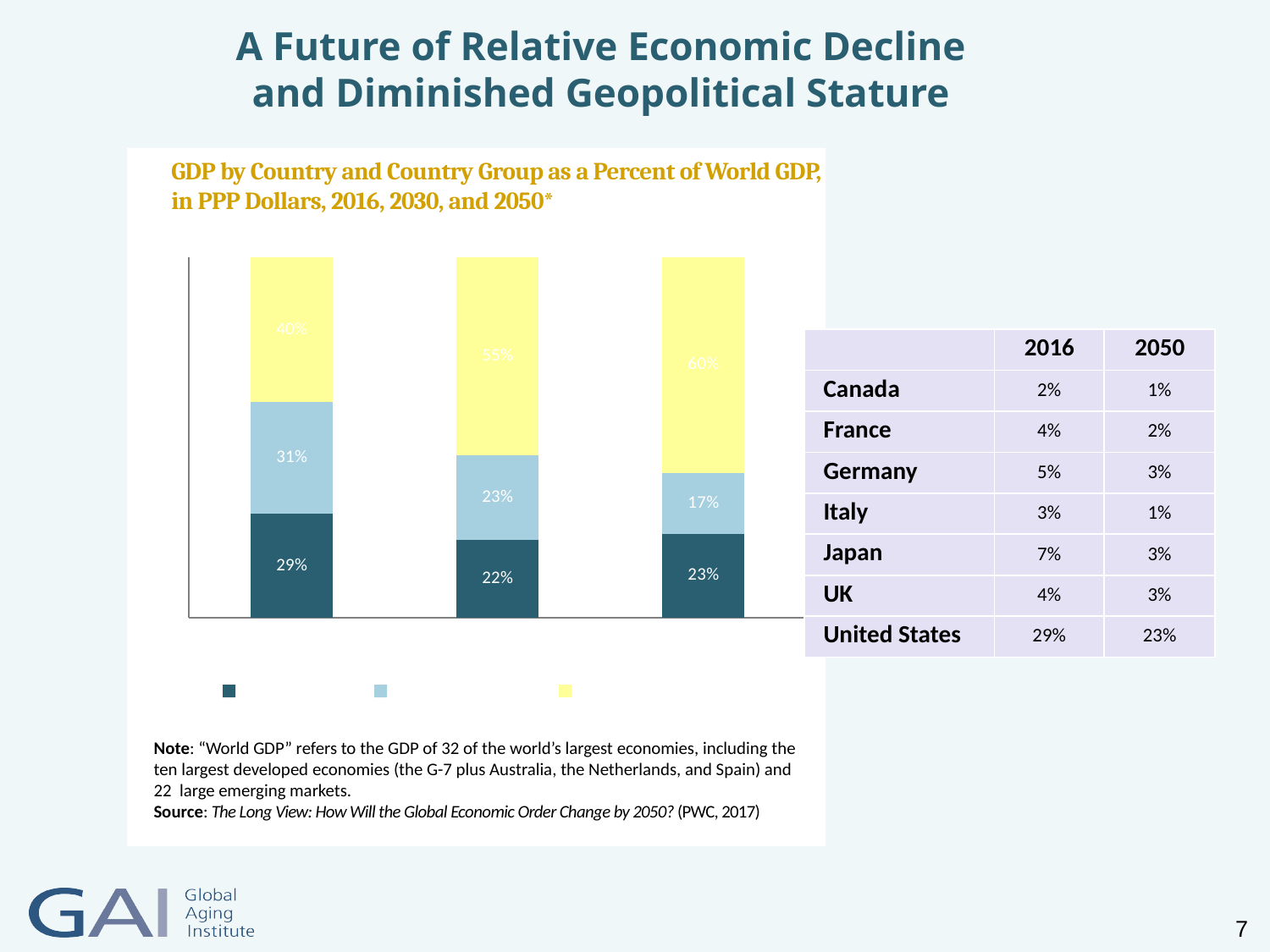
What is the difference between the yellow segment of the right-most bar and the yellow segment of the left-most bar? 20% How many series does the chart's legend list? 3 What is the title of the chart? GDP by Country and Country Group as a Percent of World GDP, in PPP Dollars, 2016, 2030, and 2050* Which bar has the smallest light blue (middle) segment? the right-most bar What is the value of the dark blue (bottom) segment of the left-most bar? 29% What is the value of the light blue (middle) segment of the middle bar? 23% What is the value of the light blue (middle) segment of the left-most bar? 31% Which bar has the largest yellow (top) segment? the right-most bar Is the dark blue (bottom) segment larger in the left-most bar or in the middle bar? the left-most bar How many bars are plotted in the chart? 3 What is the value of the yellow (top) segment of the right-most bar? 60% What kind of chart is shown on the slide? stacked bar chart